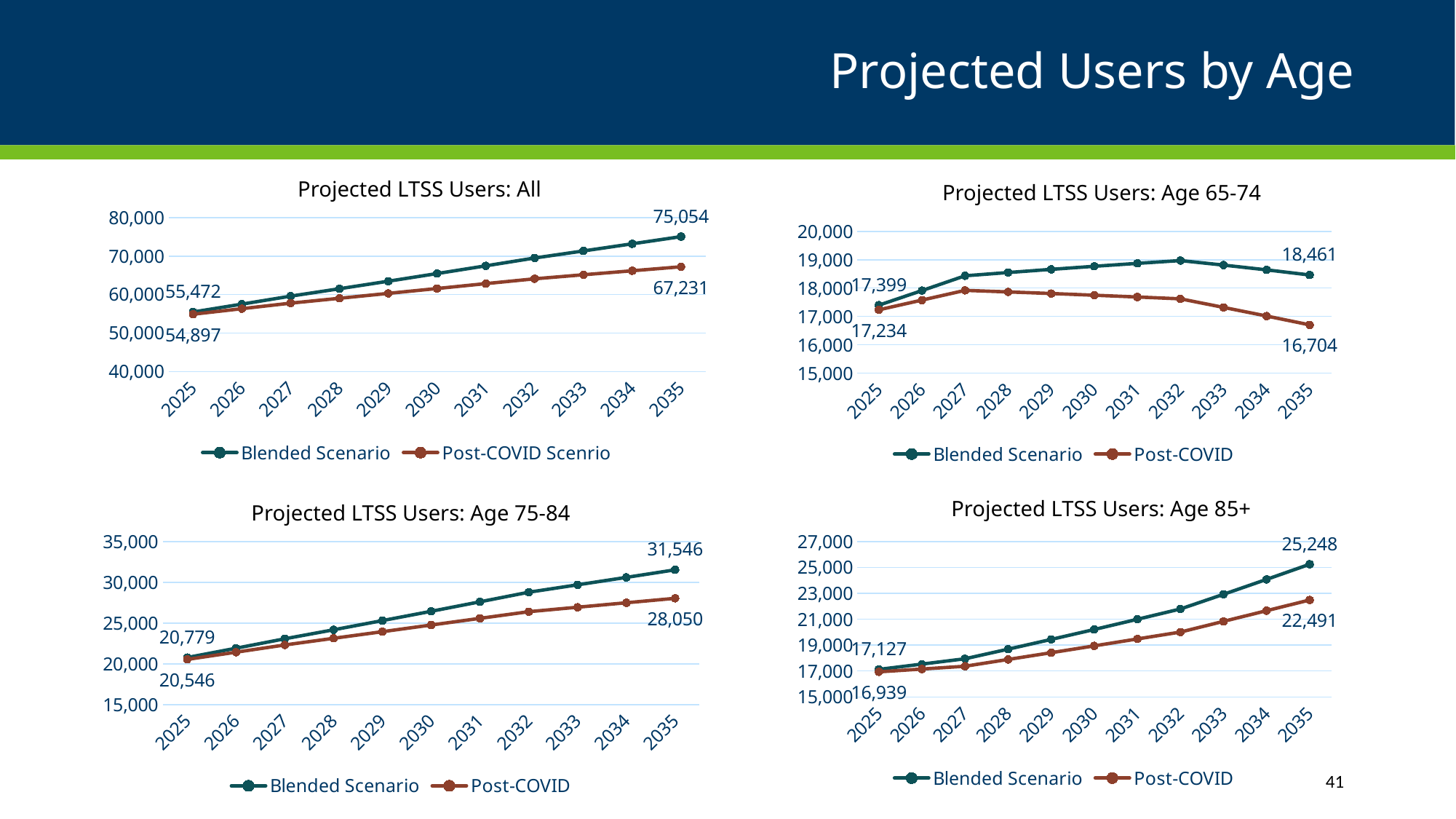
In the chart titled 'Projected LTSS Users: All', what is the difference between the Blended Scenario and Post-COVID Scenrio values in 2035? 7,823 In the chart titled 'Projected LTSS Users: Age 65-74', does the Post-COVID series rise or fall from 2025 to 2035? fall In the chart titled 'Projected LTSS Users: Age 85+', what is the Blended Scenario value in 2025? 17,127 How many series does the legend list in the chart titled 'Projected LTSS Users: Age 85+'? 2 In the chart titled 'Projected LTSS Users: Age 65-74', what is the Post-COVID value in 2035? 16,704 In the chart titled 'Projected LTSS Users: All', is the Blended Scenario value for 2030 greater or less than 60,000? greater In the chart titled 'Projected LTSS Users: Age 85+', does the Blended Scenario series rise or fall from 2025 to 2035? rise In the chart titled 'Projected LTSS Users: Age 75-84', what is the difference between the Blended Scenario and Post-COVID values in 2035? 3,496 How many years are shown on the x axis of the chart titled 'Projected LTSS Users: Age 75-84'? 11 In the chart titled 'Projected LTSS Users: All', what is the Blended Scenario value in 2035? 75,054 In the chart titled 'Projected LTSS Users: All', what is the Post-COVID Scenrio value in 2025? 54,897 In the chart titled 'Projected LTSS Users: Age 65-74', which series has the higher value in 2035, Blended Scenario or Post-COVID? Blended Scenario